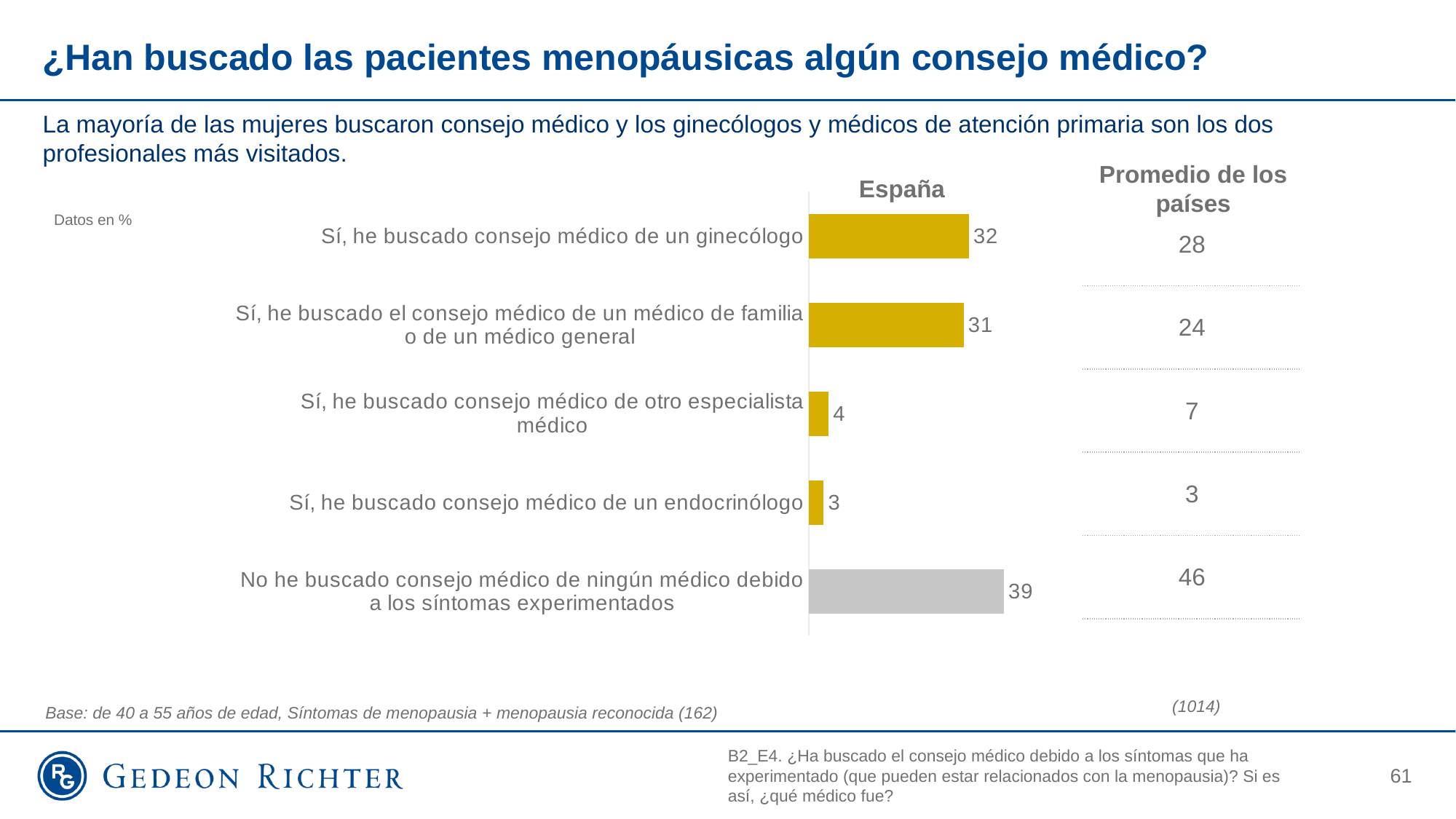
What is the value for Spain for 'Sí, he buscado consejo médico de un ginecólogo'? 32 What is the value for Spain for 'No he buscado consejo médico de ningún médico debido a los síntomas experimentados'? 39 What is the 'Promedio de los países' value for 'Sí, he buscado el consejo médico de un médico de familia o de un médico general'? 24 How many categories are shown in the bar chart? 5 What is the value for Spain for 'Sí, he buscado consejo médico de un endocrinólogo'? 3 Which is larger for 'Sí, he buscado consejo médico de otro especialista médico': the Spain value or the 'Promedio de los países' value? Promedio de los países What colour is the bar for 'No he buscado consejo médico de ningún médico debido a los síntomas experimentados'? Grey What is the difference between the Spain value for 'médico de familia o de un médico general' (31) and for 'otro especialista médico' (4)? 27 What kind of chart is used to show the Spain data? Bar chart Which category has the lowest value for Spain? Sí, he buscado consejo médico de un endocrinólogo Which category has the highest value for Spain? No he buscado consejo médico de ningún médico debido a los síntomas experimentados What is the difference between the Spain value for 'ginecólogo' (32) and the 'Promedio de los países' value for the same category (28)? 4